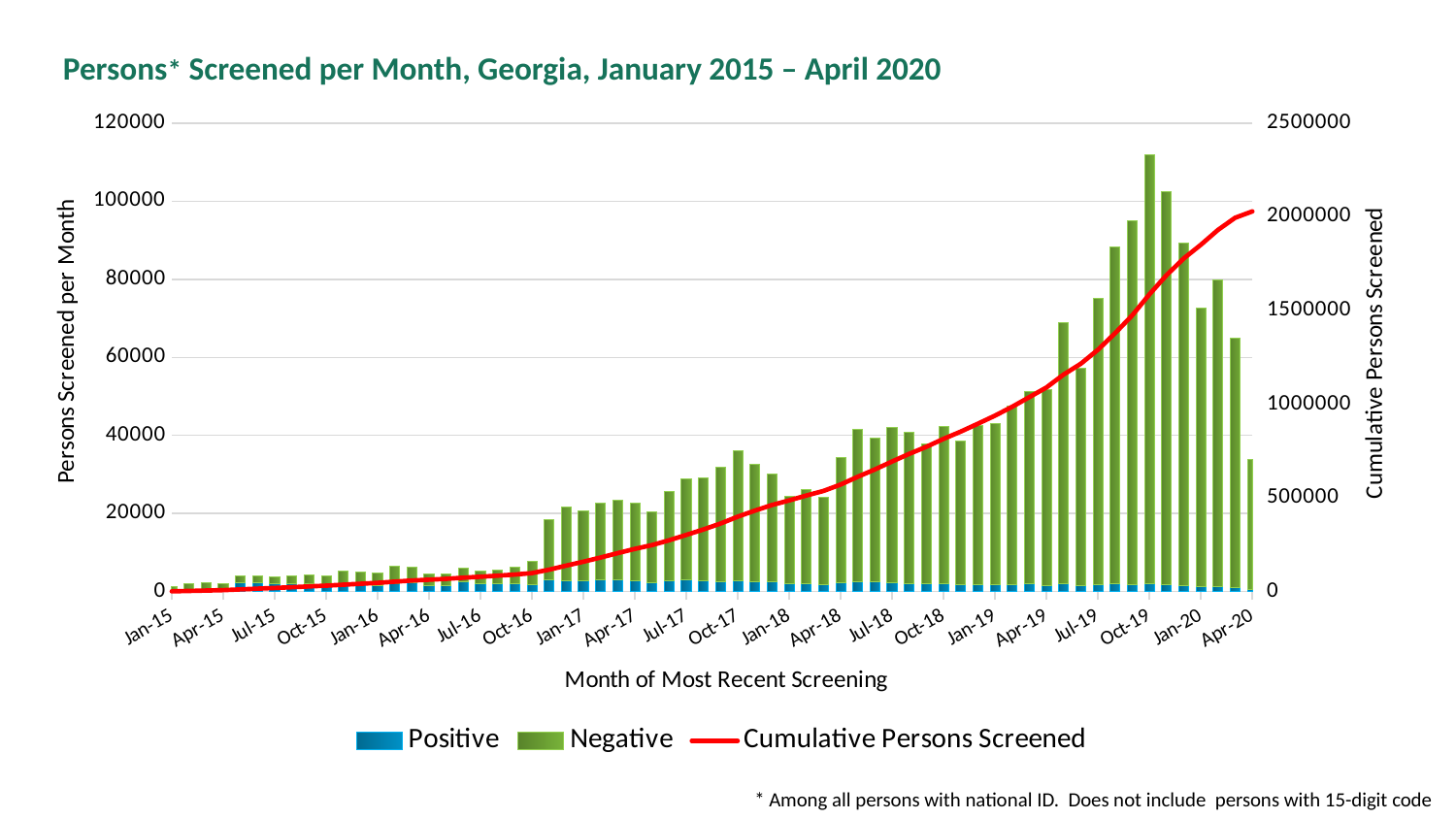
Is the cumulative persons screened in Oct-17 greater or less than 500000? less Does the Cumulative Persons Screened line rise or fall from Jan-15 to Apr-20? rise Is the total persons screened in Jan-15 greater or less than 20000? less What is the title of the chart? Persons* Screened per Month, Georgia, January 2015 – April 2020 Is the total persons screened in Oct-19 greater or less than 100000? greater Which month has more persons screened, Jan-17 or Jan-19? Jan-19 What kind of chart is shown on the slide? Stacked bar chart with a line How many series does the legend list? 3 Which series is plotted as a red line? Cumulative Persons Screened Which month has the tallest bar for persons screened per month? Oct-19